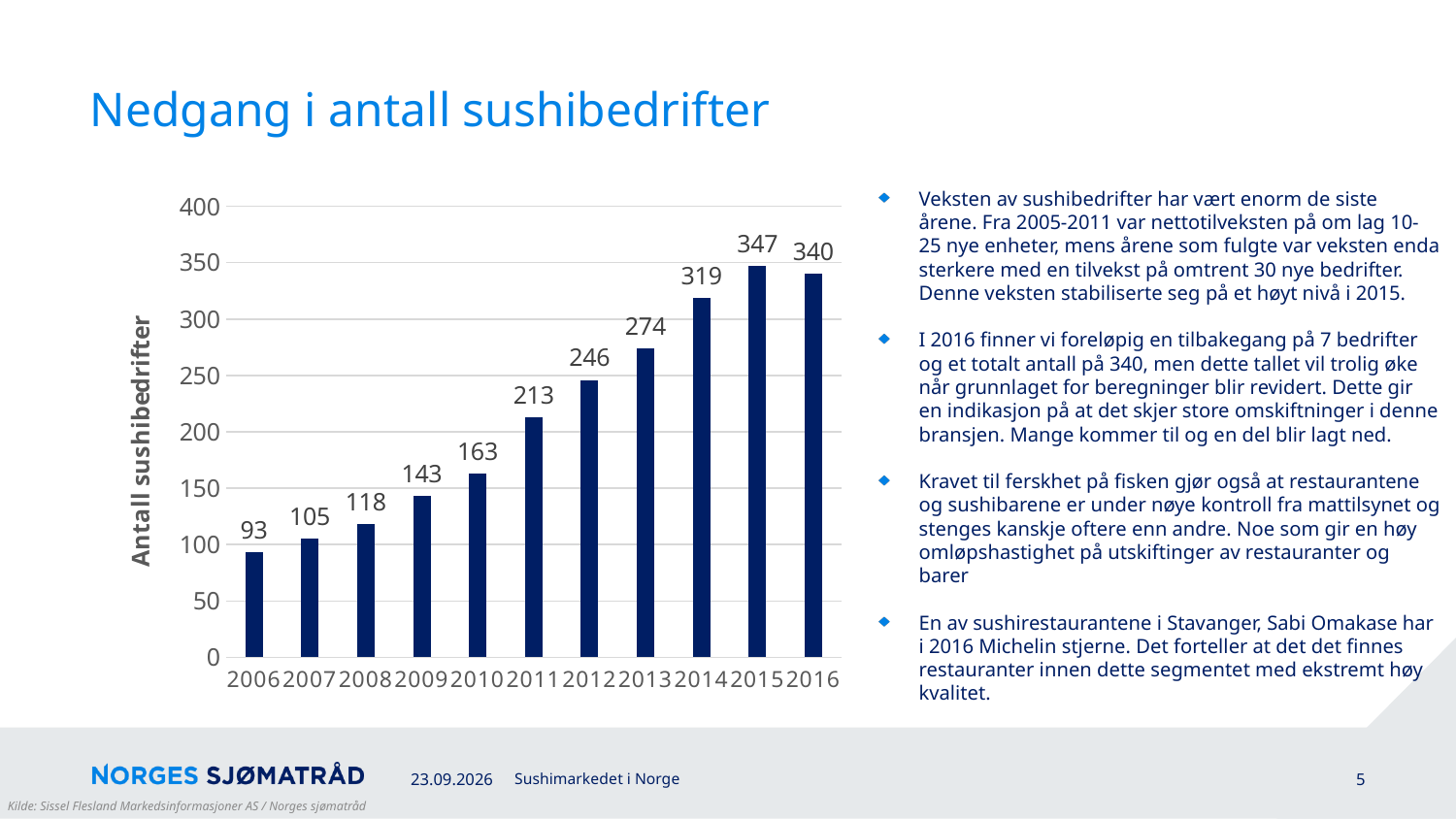
Is the value for 2009 greater or less than 150? less What is the difference between the values for 2014 and 2013? 45 Do the values rise or fall from 2006 to 2015? rise How many years are shown on the x axis? 11 What is the difference between the values for 2015 and 2016? 7 Which year has the lowest number of sushi businesses? 2006 What is the value shown for 2006? 93 Which is larger, the value for 2010 or the value for 2011? 2011 What is the number of sushi businesses in 2012? 246 Which year has the highest number of sushi businesses? 2015 What kind of chart is shown on the slide? bar chart What is the label on the vertical axis of the chart? Antall sushibedrifter